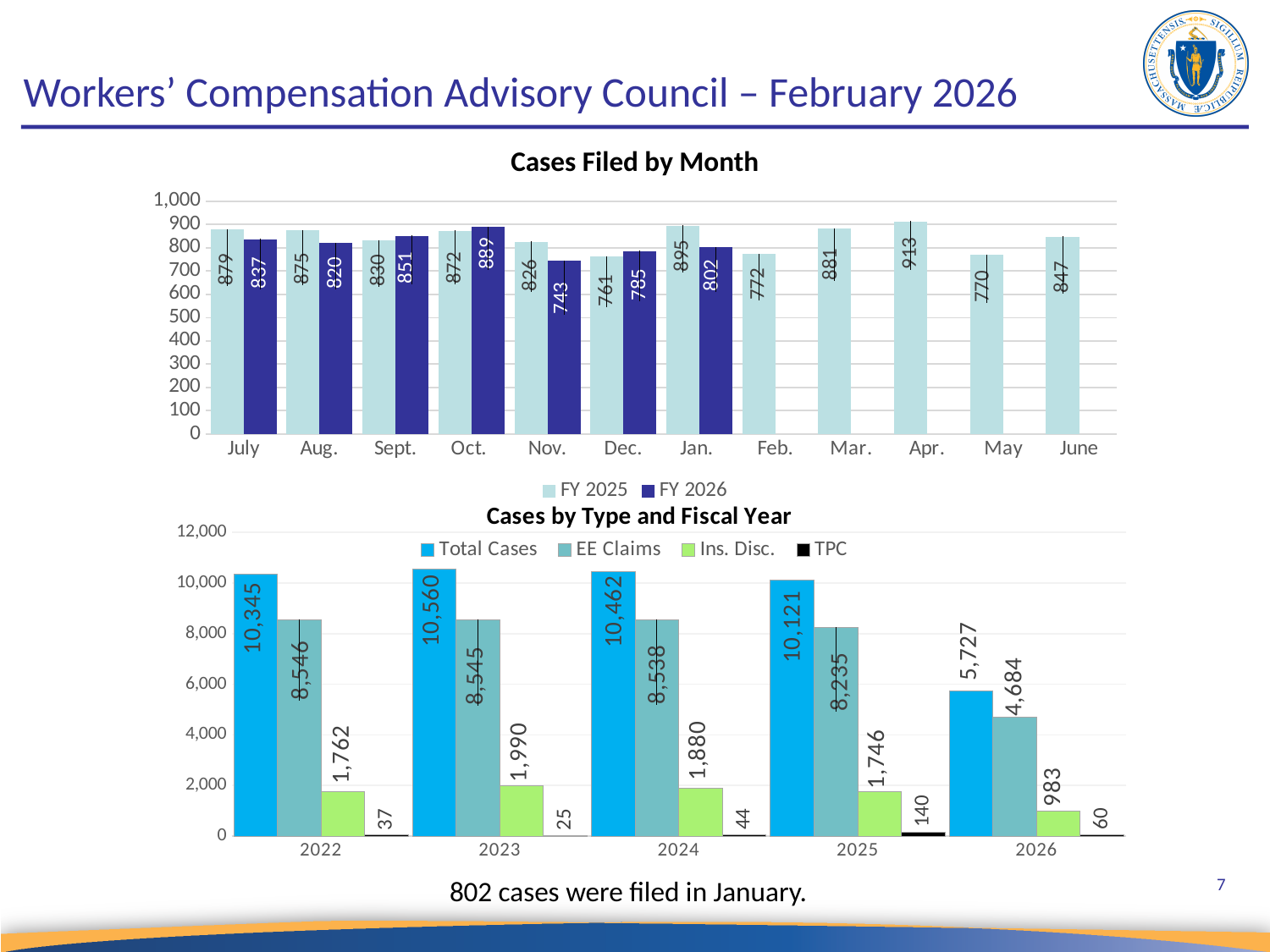
In the 'Cases by Type and Fiscal Year' chart, which year has the highest TPC value? 2025 In the 'Cases Filed by Month' chart, which is larger for September: FY 2025 or FY 2026? FY 2026 What type of chart is 'Cases by Type and Fiscal Year'? Bar chart In the 'Cases Filed by Month' chart, what is the difference between the FY 2025 and FY 2026 values for January? 93 In the 'Cases by Type and Fiscal Year' chart, how many series does the legend list? 4 In the 'Cases by Type and Fiscal Year' chart, what is the difference between EE Claims in 2024 and 2025? 303 In the 'Cases Filed by Month' chart, what is the FY 2026 value for October? 889 In the 'Cases Filed by Month' chart, how many months have an FY 2026 bar? 7 In the 'Cases Filed by Month' chart, how many series does the legend list? 2 In the 'Cases Filed by Month' chart, which month has the highest FY 2025 value? Apr. In the 'Cases by Type and Fiscal Year' chart, what is the Total Cases value for 2023? 10,560 In the 'Cases Filed by Month' chart, which month has the lowest FY 2026 value? Nov.